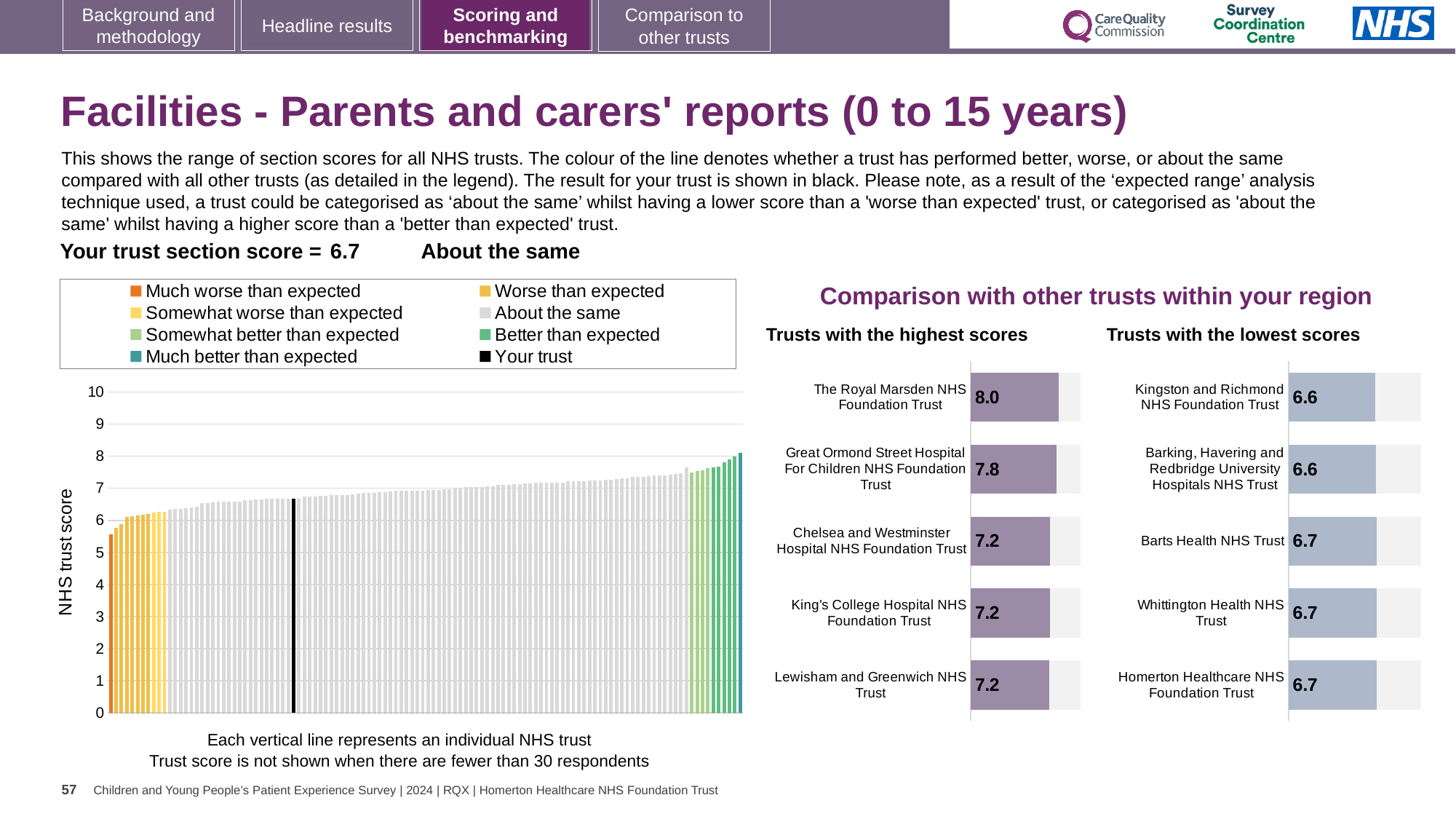
In the 'Trusts with the highest scores' chart, what is the score for Great Ormond Street Hospital For Children NHS Foundation Trust? 7.8 How many entries does the legend of the main 'NHS trust score' chart on the left list? 8 How many trusts are listed in the 'Trusts with the lowest scores' chart? 5 In the 'Trusts with the highest scores' chart, what is the difference between the scores of The Royal Marsden NHS Foundation Trust and Great Ormond Street Hospital For Children NHS Foundation Trust? 0.2 In the 'Trusts with the highest scores' chart, what is the score for The Royal Marsden NHS Foundation Trust? 8.0 In the main 'NHS trust score' chart on the left, is the value of the leftmost (lowest) bar greater or less than 6? less In the 'Trusts with the highest scores' chart, which trust has the highest score? The Royal Marsden NHS Foundation Trust In the 'Trusts with the lowest scores' chart, what is the score for Kingston and Richmond NHS Foundation Trust? 6.6 In the 'Trusts with the lowest scores' chart, what is the score for Homerton Healthcare NHS Foundation Trust? 6.7 In the main 'NHS trust score' chart on the left, do the values rise or fall from left to right? Rise Which is larger: the score for The Royal Marsden NHS Foundation Trust in the 'Trusts with the highest scores' chart, or the score for Barts Health NHS Trust in the 'Trusts with the lowest scores' chart? The Royal Marsden NHS Foundation Trust What kind of chart is the main 'NHS trust score' chart on the left of the slide? Bar chart